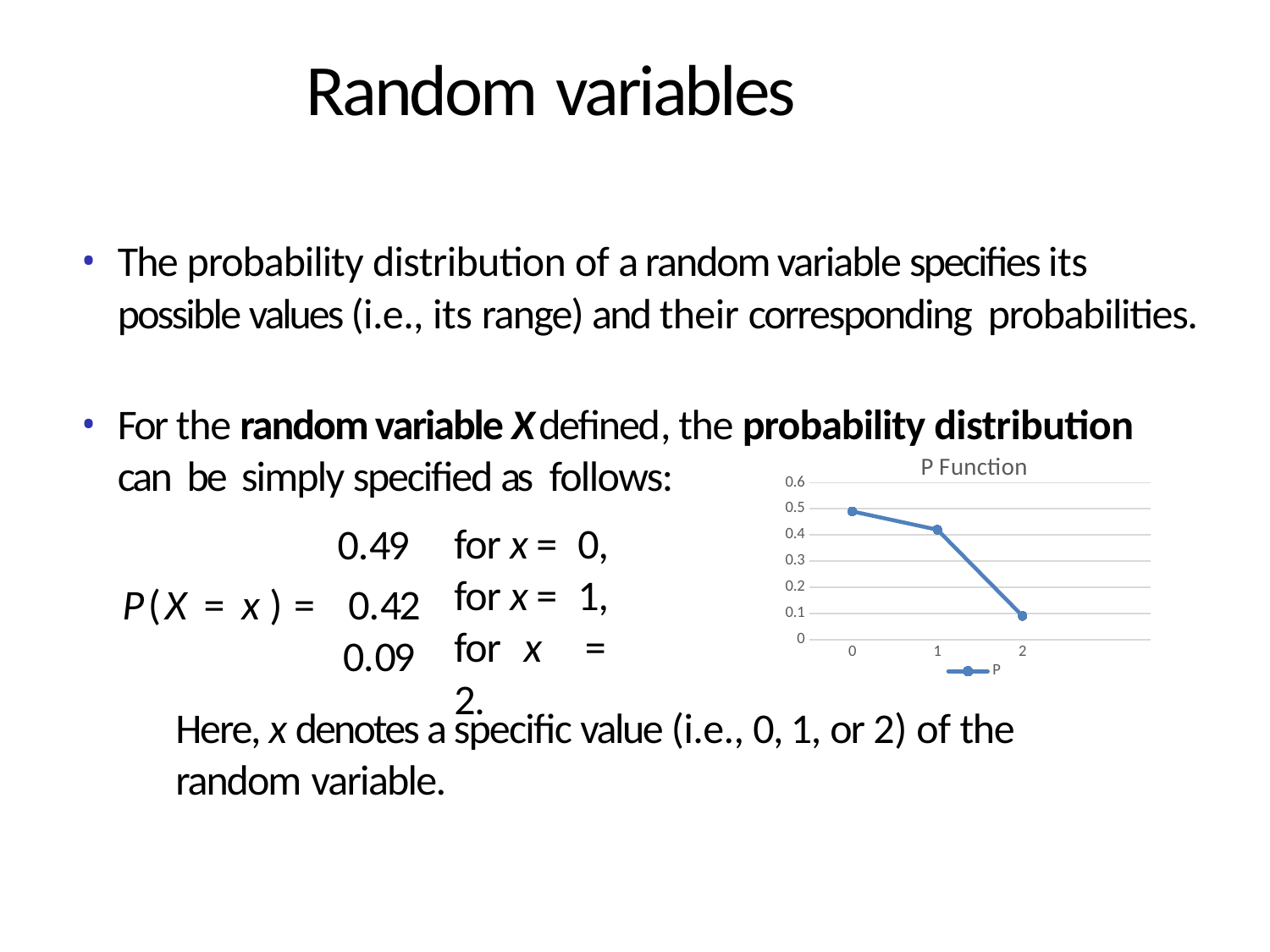
Is the plotted value for x = 0 greater or less than 0.4? greater Which x value has the lowest plotted value in the chart? 2 How many data points are plotted in the chart? 3 Which is larger, the plotted value for x = 1 or for x = 2? x = 1 How many series does the chart legend list? 1 According to the slide, what is the value of P(X = x) for x = 1 plotted in the chart? 0.42 Which x value has the highest plotted value in the chart? 0 What is the name of the series in the chart legend? P What is the title of the chart? P Function Do the values in the chart rise or fall as x goes from 0 to 2? fall Is the plotted value for x = 2 greater or less than 0.2? less What kind of chart is shown on the slide? line chart